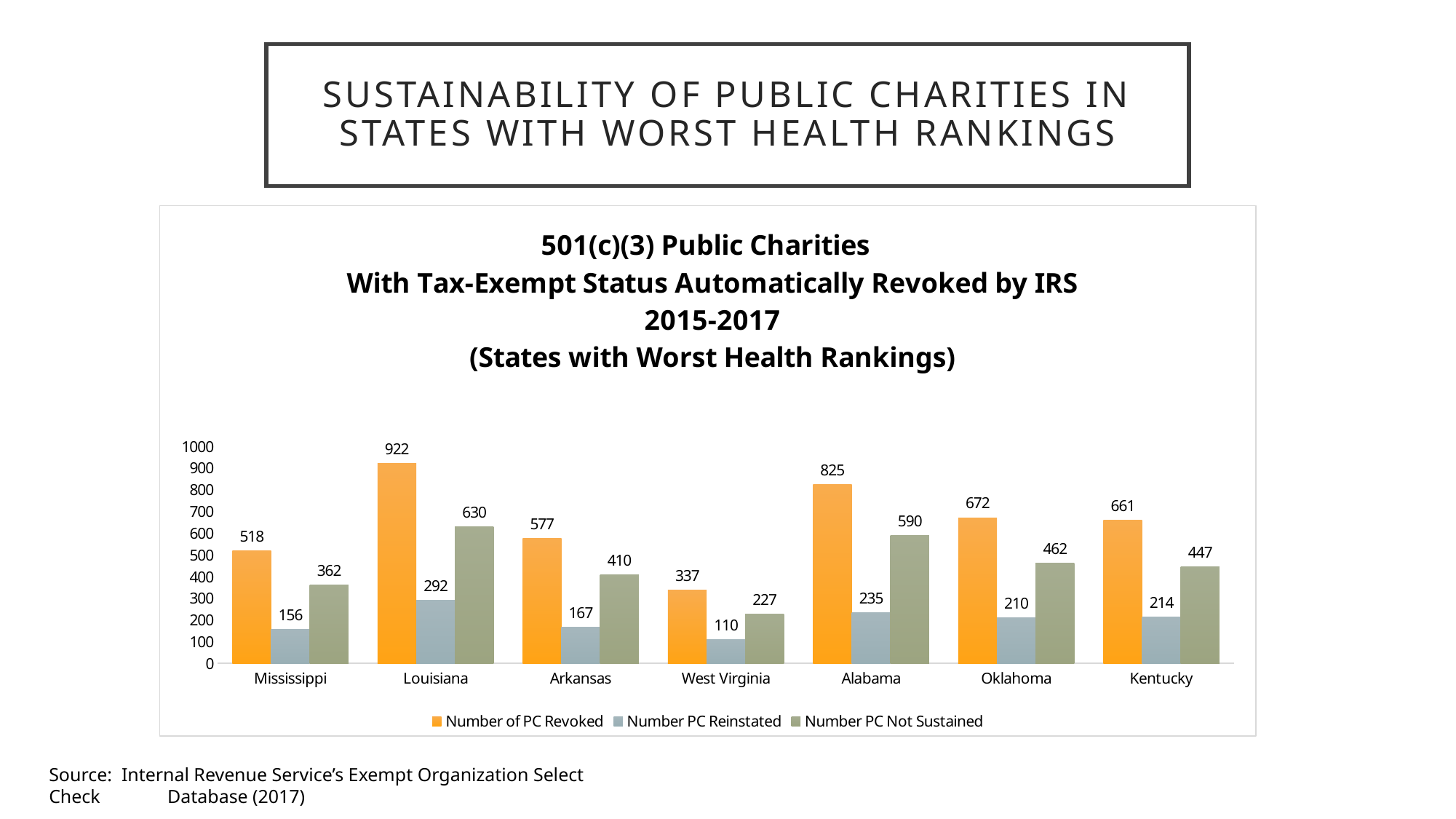
What is the difference between the Number of PC Revoked and the Number PC Not Sustained for Kentucky? 214 How many series does the legend list? 3 What is the Number of PC Revoked for Louisiana? 922 How many states are shown on the x axis? 7 Which state has the highest Number of PC Revoked? Louisiana Which series is shown in orange in the legend? Number of PC Revoked Which is larger: the Number PC Reinstated for Louisiana or for Alabama? Louisiana What kind of chart is shown on the slide? Bar chart What is the Number PC Reinstated for West Virginia? 110 What is the Number PC Not Sustained for Alabama? 590 Is the Number of PC Revoked for Oklahoma greater or less than 600? greater Which state has the lowest Number PC Not Sustained? West Virginia